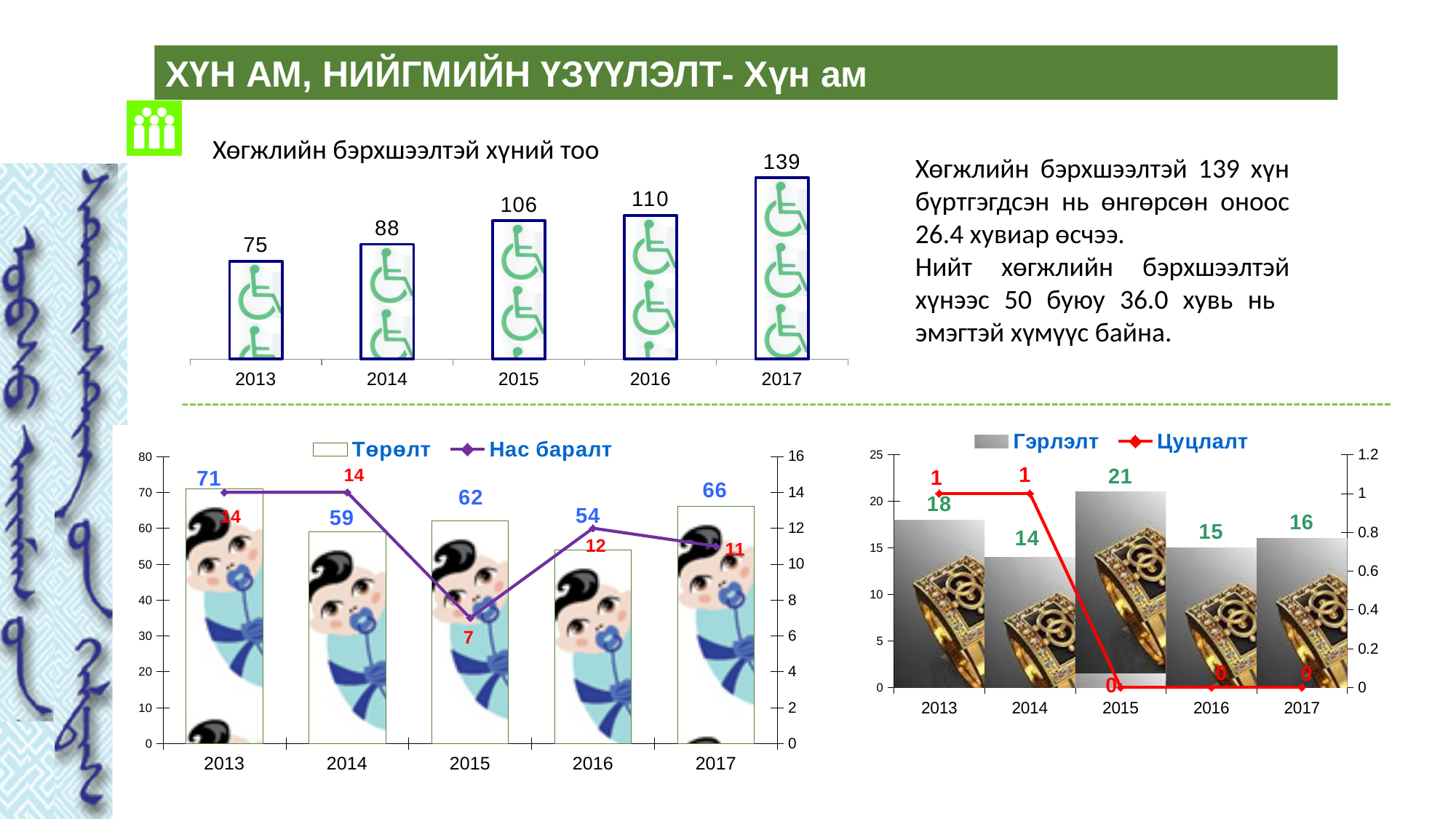
In the chart titled 'Хөгжлийн бэрхшээлтэй хүний тоо', what is the value for 2015? 106 In the bottom-right chart, which year has the lowest Гэрлэлт value? 2014 In the chart titled 'Хөгжлийн бэрхшээлтэй хүний тоо', do the values rise or fall from 2013 to 2017? rise In the bottom-right chart, how many years are shown on the x axis? 5 In the bottom-left chart, what is the Нас баралт value for 2015? 7 In the chart titled 'Хөгжлийн бэрхшээлтэй хүний тоо', what is the difference between the 2017 and 2016 values? 29 In the bottom-left chart, what is the Төрөлт value for 2016? 54 In the bottom-right chart, what is the Цуцлалт value for 2017? 0 In the bottom-right chart, what is the Гэрлэлт value for 2015? 21 In the bottom-left chart, which year has the lowest Төрөлт value? 2016 In the bottom-left chart, how many series does the legend list? 2 In the chart titled 'Хөгжлийн бэрхшээлтэй хүний тоо', which year has the highest value? 2017